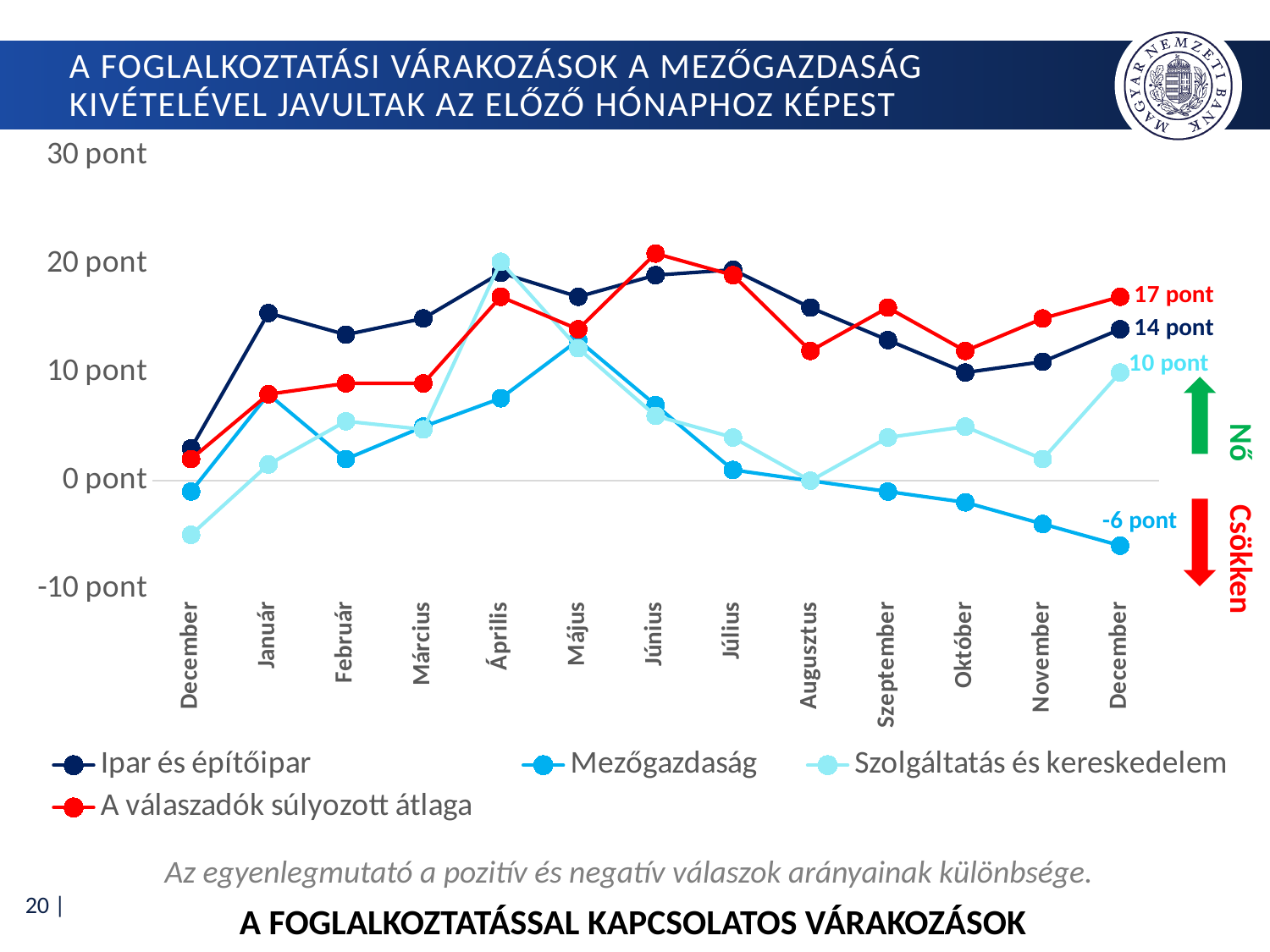
What is the value for 'Mezőgazdaság' in the final December? -6 pont How many series does the legend list? 4 Is the value for 'Mezőgazdaság' in Augusztus greater or less than 10 pont? less What is the value for 'Szolgáltatás és kereskedelem' in the final December? 10 pont How many months are shown on the x axis? 13 What type of chart is shown on the slide? line chart What is the value for 'A válaszadók súlyozott átlaga' in the final December? 17 pont What is the value for 'Ipar és építőipar' in the final December? 14 pont Which series has the lowest value in the final December? Mezőgazdaság Does the 'Mezőgazdaság' series rise or fall from Május to the final December? fall What is the difference between 'A válaszadók súlyozott átlaga' and 'Ipar és építőipar' in the final December? 3 pont Which series has the highest value in the final December? A válaszadók súlyozott átlaga